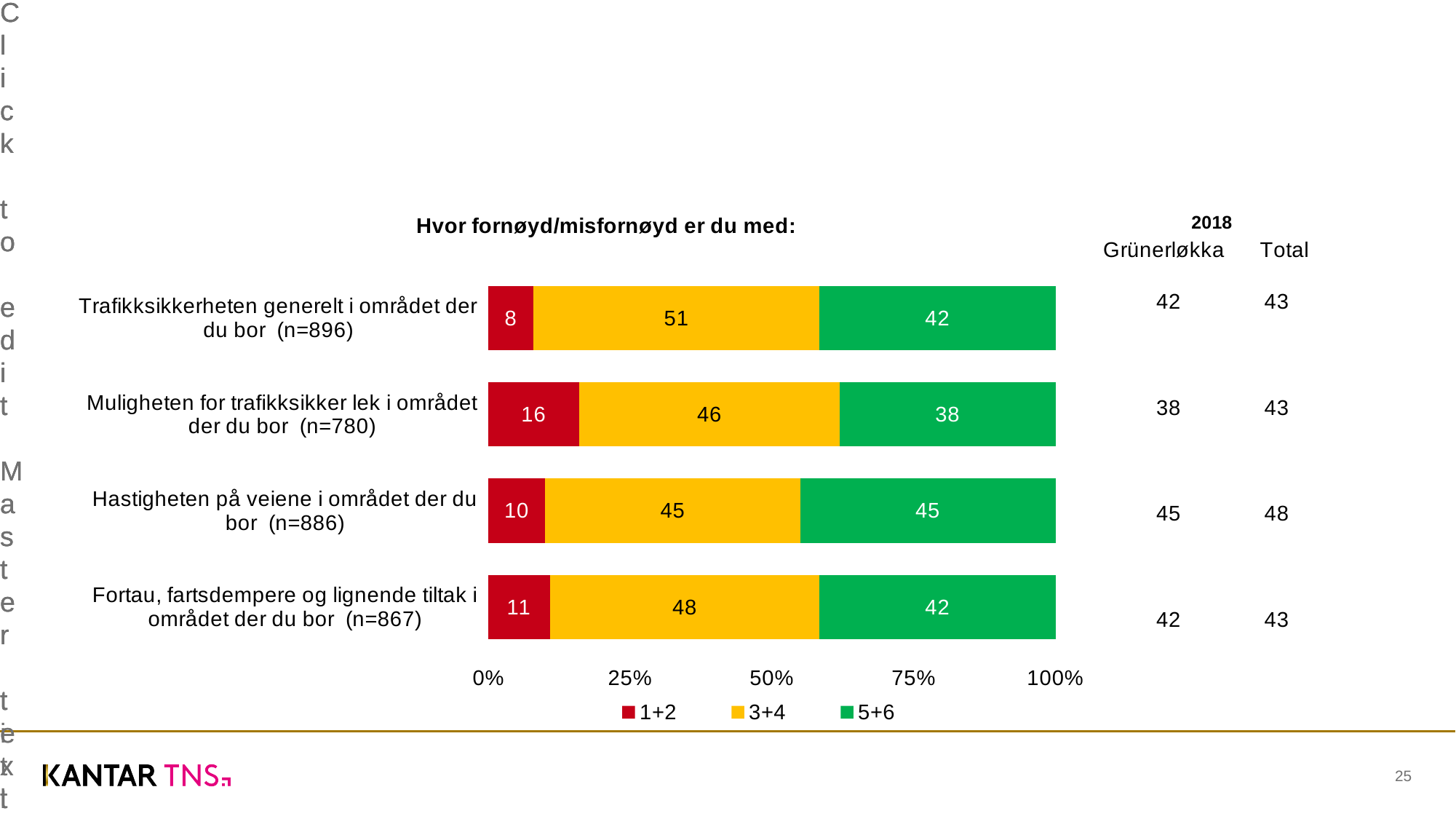
Which has the larger 3+4 value: "Fortau, fartsdempere og lignende tiltak i området der du bor (n=867)" or "Hastigheten på veiene i området der du bor (n=886)"? Fortau, fartsdempere og lignende tiltak i området der du bor (n=867) What is the difference between the 5+6 value for "Trafikksikkerheten generelt i området der du bor (n=896)" and the 5+6 value for "Muligheten for trafikksikker lek i området der du bor (n=780)"? 4 Which category has the lowest 5+6 value? Muligheten for trafikksikker lek i området der du bor (n=780) What is the value of the 5+6 segment for "Hastigheten på veiene i området der du bor (n=886)"? 45 Which category has the highest 1+2 value? Muligheten for trafikksikker lek i området der du bor (n=780) How many series does the legend list? 3 What is the title of the chart? Hvor fornøyd/misfornøyd er du med: What is the value of the 1+2 segment for "Muligheten for trafikksikker lek i området der du bor (n=780)"? 16 What kind of chart is shown on the slide? Stacked bar chart What is the value of the 3+4 segment for "Fortau, fartsdempere og lignende tiltak i området der du bor (n=867)"? 48 How many categories are plotted in the chart? 4 Which category has the highest 3+4 value? Trafikksikkerheten generelt i området der du bor (n=896)